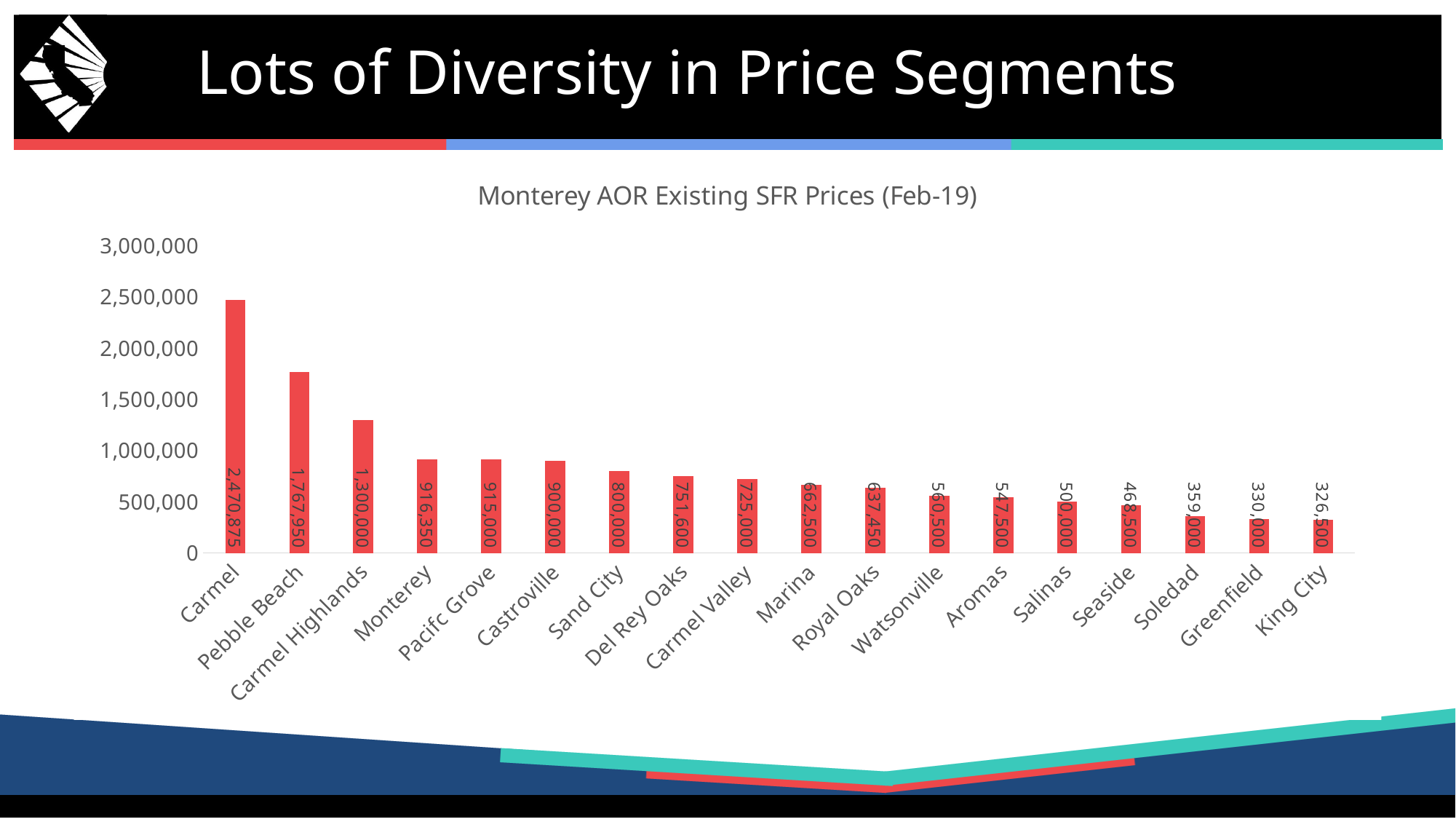
Is the price for Pebble Beach greater or less than 1,500,000? greater Which has a higher price, Carmel Highlands or Monterey? Carmel Highlands What is the difference between the prices for Carmel and Pebble Beach? 702,925 What is the price for Del Rey Oaks? 751,600 What is the price for Salinas? 500,000 What is the price for Carmel? 2,470,875 Which area has the highest price? Carmel Do the prices rise or fall from left to right along the x axis? Fall What is the difference between the prices for Sand City and Seaside? 331,500 How many areas are shown in the chart? 18 Which area has the lowest price? King City What kind of chart is shown on the slide? Bar chart